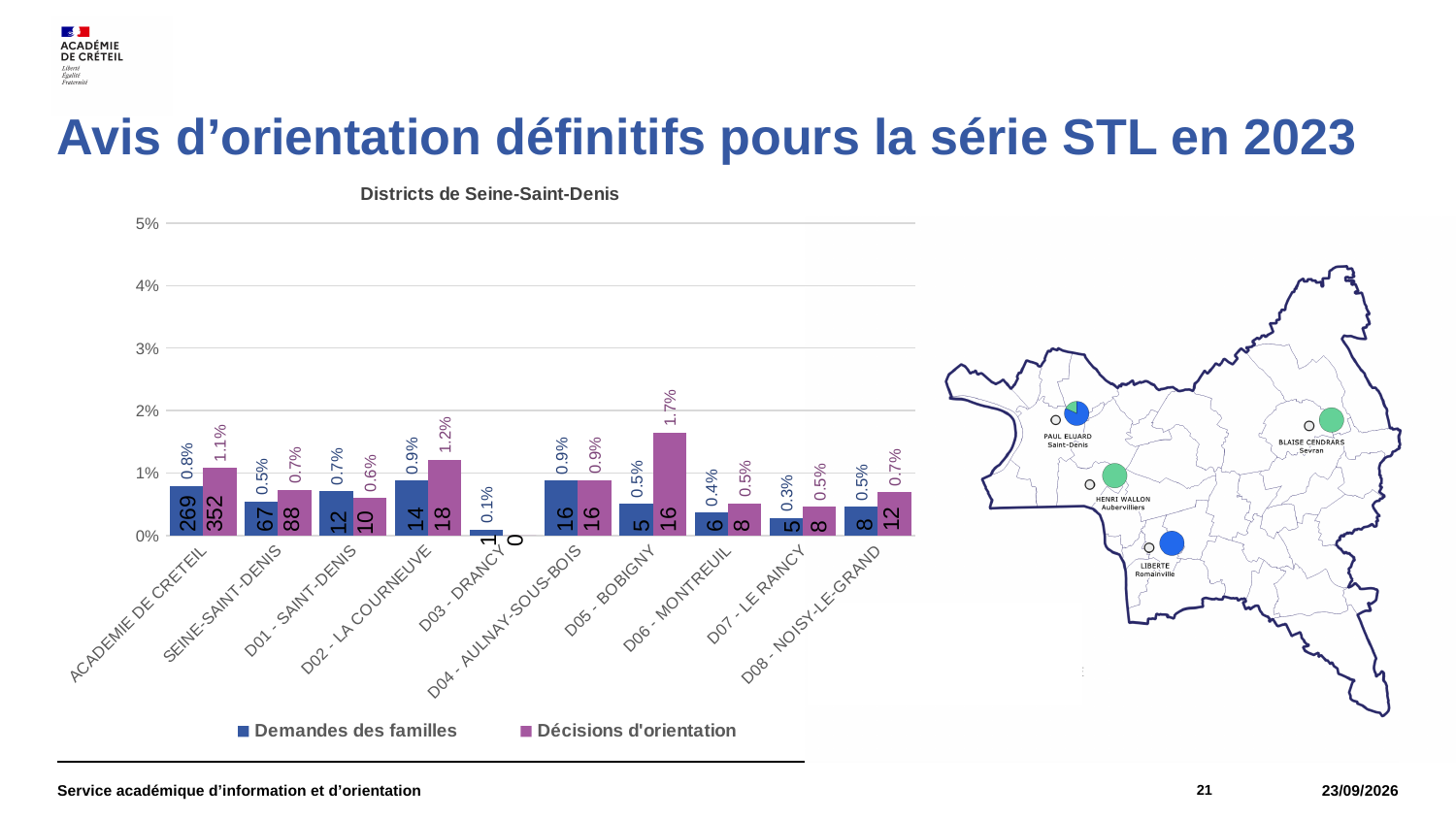
What is the "Demandes des familles" percentage for ACADEMIE DE CRETEIL? 0.8% How many categories are shown on the x axis of the chart? 10 What is the difference between the "Décisions d'orientation" and "Demandes des familles" percentages for D02 - LA COURNEUVE? 0.3% What number is printed on the "Décisions d'orientation" bar for ACADEMIE DE CRETEIL? 352 What number is printed on the "Demandes des familles" bar for SEINE-SAINT-DENIS? 67 Which category has the highest "Décisions d'orientation" percentage? D05 - BOBIGNY Which category has the lowest "Demandes des familles" percentage among those with a printed percentage label? D03 - DRANCY What is the "Décisions d'orientation" percentage for D05 - BOBIGNY? 1.7% What type of chart is shown under the title "Districts de Seine-Saint-Denis"? bar chart How many series does the legend of the chart list? 2 Is the "Décisions d'orientation" value for D05 - BOBIGNY greater or less than 2%? less For D01 - SAINT-DENIS, which is larger: "Demandes des familles" or "Décisions d'orientation"? Demandes des familles